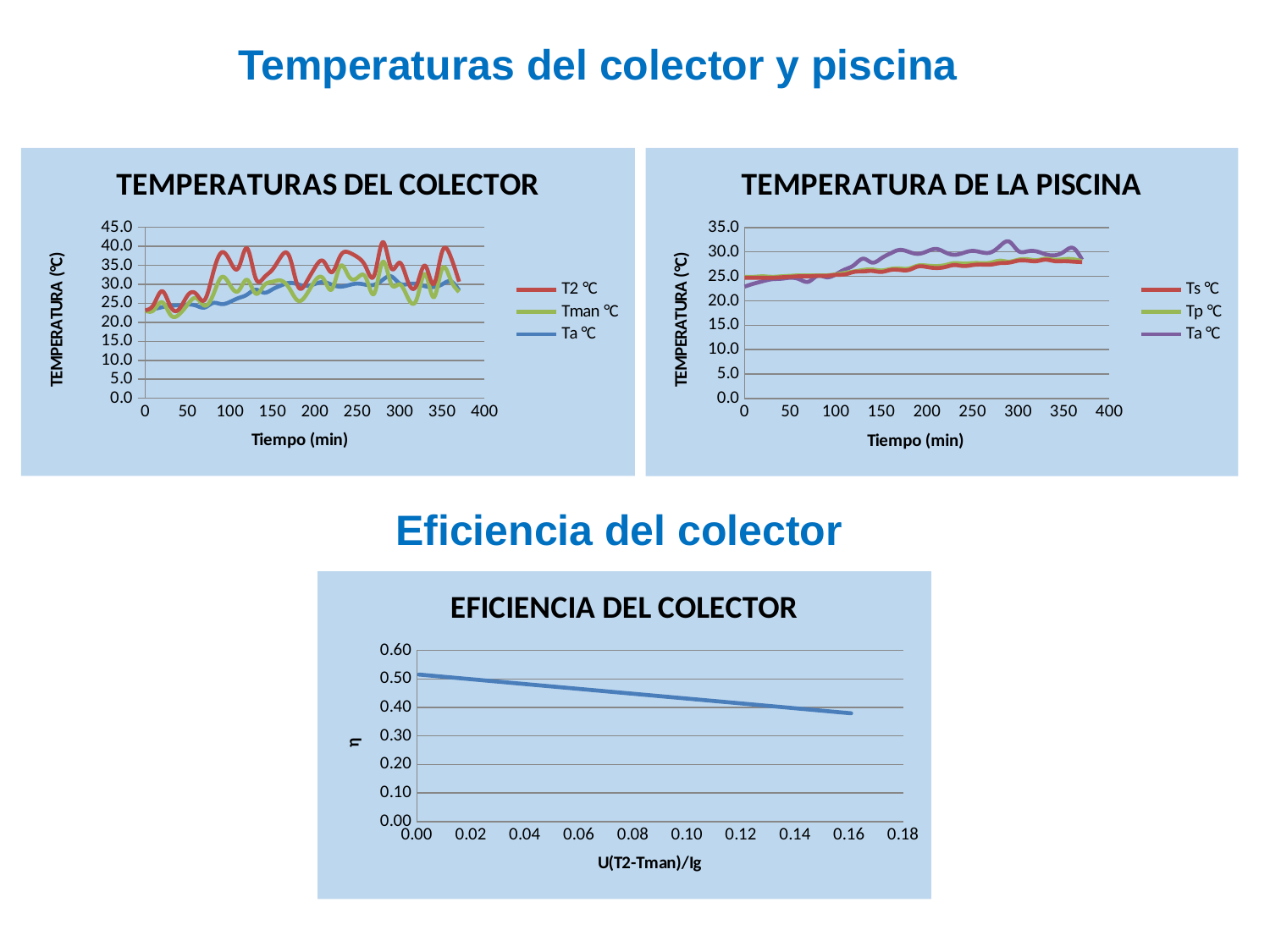
Which series in the 'TEMPERATURAS DEL COLECTOR' chart is drawn in red? T2 °C In the 'EFICIENCIA DEL COLECTOR' chart, does the efficiency η rise or fall as U(T2-Tman)/Ig increases? fall In the 'TEMPERATURA DE LA PISCINA' chart, is the Ts °C value at 0 min greater or less than 30.0? less What kind of chart is the 'TEMPERATURAS DEL COLECTOR' chart? line chart In the 'TEMPERATURA DE LA PISCINA' chart, is the peak value of the Ta °C series greater or less than 30.0? greater In the 'TEMPERATURAS DEL COLECTOR' chart, is the T2 °C value at 0 min greater or less than 30.0? less How many series does the legend of the 'TEMPERATURA DE LA PISCINA' chart list? 3 How many series does the legend of the 'TEMPERATURAS DEL COLECTOR' chart list? 3 What kind of chart is the 'EFICIENCIA DEL COLECTOR' chart? line chart In the 'TEMPERATURA DE LA PISCINA' chart, does the Ts °C series generally rise or fall over time? rise What is the x-axis label of the 'EFICIENCIA DEL COLECTOR' chart? U(T2-Tman)/Ig